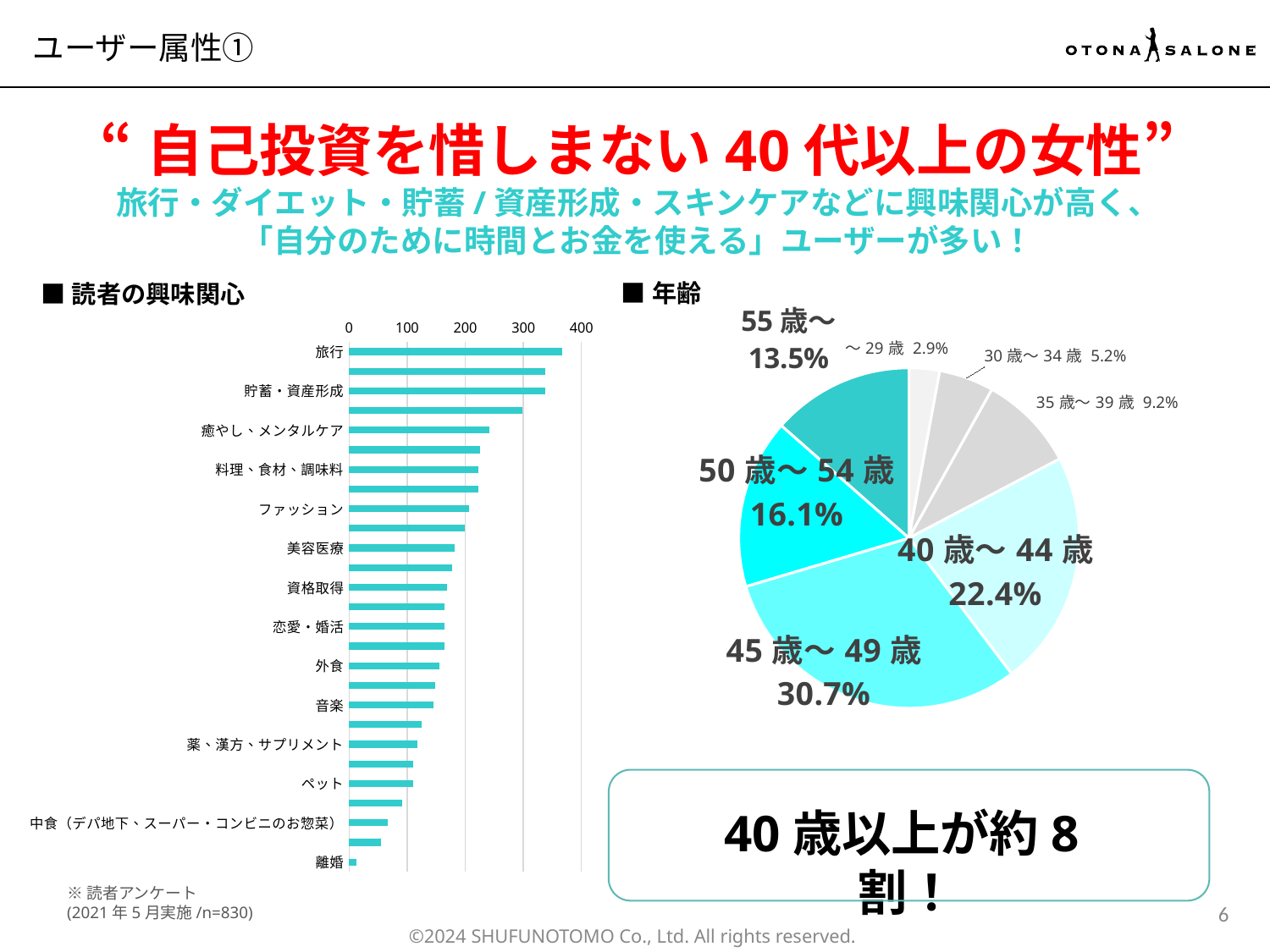
In the 読者の興味関心 bar chart, is the value for 旅行 greater or less than 300? greater What kind of chart is the 読者の興味関心 chart on the left? bar chart In the 年齢 pie chart, which age group has the smallest share? ～29歳 In the 年齢 pie chart, how many percentage points larger is 45歳～49歳 than 40歳～44歳? 8.3 In the 読者の興味関心 bar chart, which is larger, 旅行 or 外食? 旅行 In the 読者の興味関心 bar chart, is the value for 美容医療 greater or less than 200? less What kind of chart is the 年齢 chart on the right? pie chart In the 年齢 pie chart, what share is 55歳～? 13.5% In the 読者の興味関心 bar chart, is the value for 音楽 greater or less than 100? greater In the 読者の興味関心 bar chart, which category has the highest value? 旅行 In the 読者の興味関心 bar chart, which labelled category has the lowest value? 離婚 In the 年齢 pie chart, what share is 45歳～49歳? 30.7%